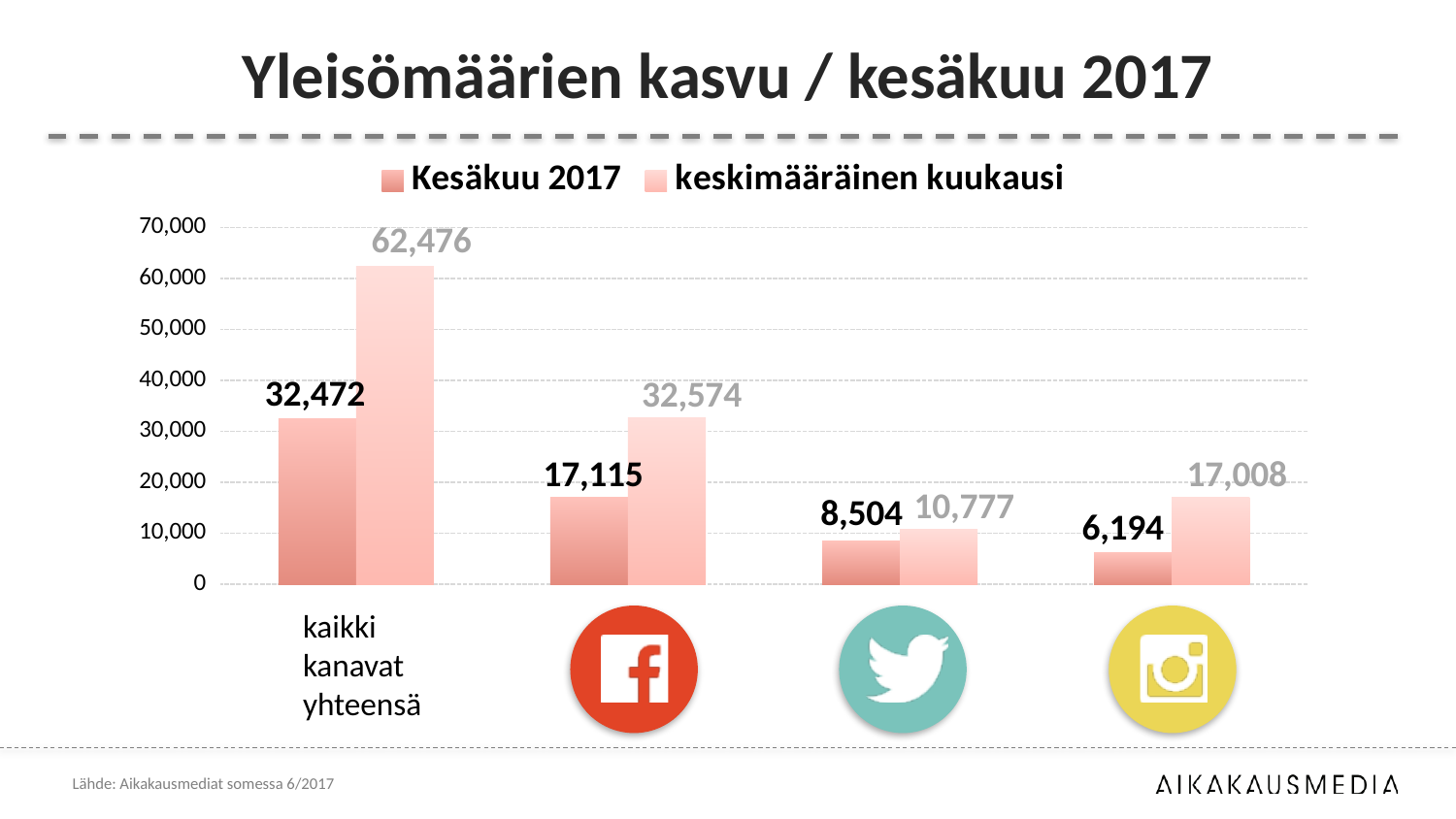
What is the Kesäkuu 2017 value for the Instagram category? 6,194 What is the keskimääräinen kuukausi value for the Twitter category? 10,777 What is the keskimääräinen kuukausi value for kaikki kanavat yhteensä? 62,476 What is the Kesäkuu 2017 value for kaikki kanavat yhteensä? 32,472 How many series does the legend list? 2 Which is larger for the Twitter category: the Kesäkuu 2017 value or the keskimääräinen kuukausi value? keskimääräinen kuukausi What is the title of the chart on the slide? Yleisömäärien kasvu / kesäkuu 2017 Which category has the lowest Kesäkuu 2017 value? Instagram What kind of chart is shown on the slide? bar chart What is the Kesäkuu 2017 value for the Facebook category? 17,115 What is the difference between the keskimääräinen kuukausi and Kesäkuu 2017 values for the Facebook category? 15,459 How many categories are shown on the x axis? 4